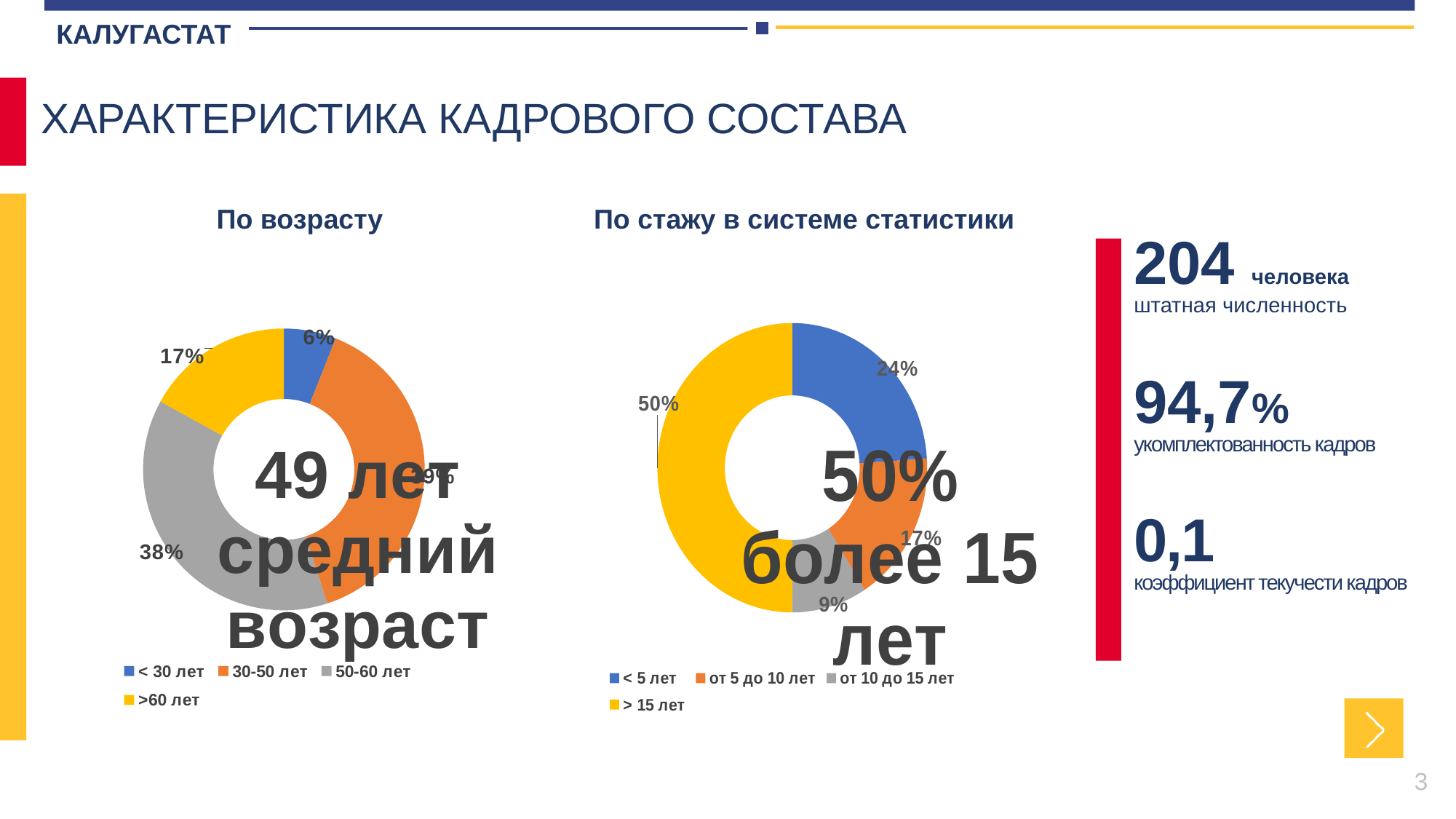
How many categories does the legend of the 'По стажу в системе статистики' chart list? 4 In the 'По возрасту' chart, what percentage is shown for the '50-60 лет' category? 38% In the 'По стажу в системе статистики' chart, what percentage is shown for '< 5 лет'? 24% In the 'По стажу в системе статистики' chart, what is the difference between the '> 15 лет' and '< 5 лет' shares? 26% In the 'По возрасту' chart, what percentage is shown for the '>60 лет' category? 17% In the 'По возрасту' chart, what percentage is shown for the '< 30 лет' category? 6% In the 'По стажу в системе статистики' chart, which category has the largest share? > 15 лет What type of chart is used for 'По возрасту'? Doughnut (pie) chart In the 'По возрасту' chart, which category has the smallest share? < 30 лет In the 'По возрасту' chart, what is the difference between the '50-60 лет' and '>60 лет' shares? 21% In the 'По стажу в системе статистики' chart, which is larger: '< 5 лет' or 'от 5 до 10 лет'? < 5 лет In the 'По стажу в системе статистики' chart, what percentage is shown for 'от 10 до 15 лет'? 9%